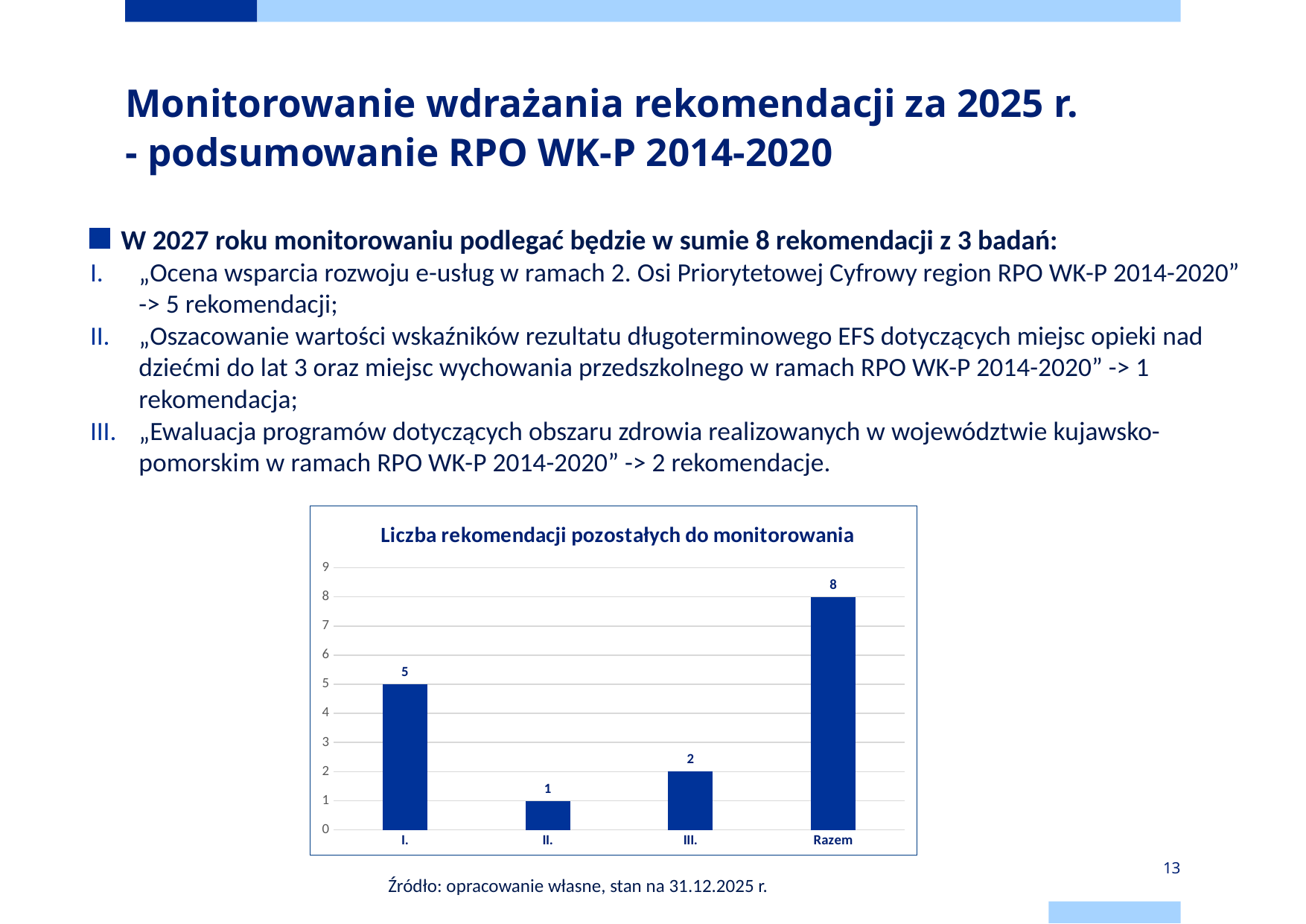
Which category has the lowest value in the chart? II. What kind of chart is shown on the slide? bar chart What is the value for category I. in the chart? 5 What is the difference between the values for I. and III.? 3 How many categories are shown on the x axis of the chart? 4 What is the value for category II. in the chart? 1 Is the value for Razem greater or less than 6? greater What is the value for category III. in the chart? 2 What is the value for Razem in the chart? 8 Which category has the highest value in the chart? Razem Which is larger, the value for I. or the value for III.? I. What is the title of the chart? Liczba rekomendacji pozostałych do monitorowania